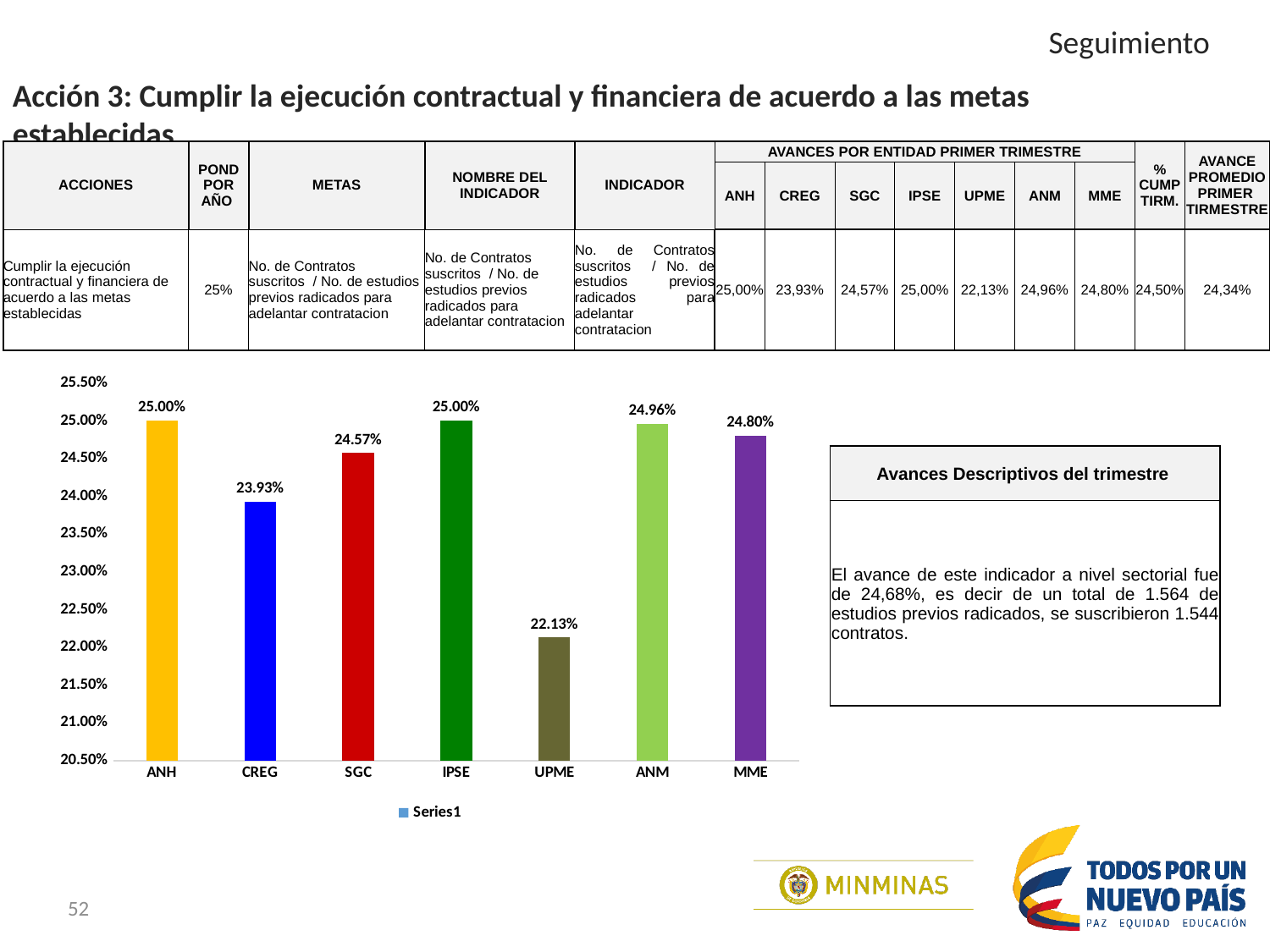
Which is larger, the value for SGC or the value for CREG? SGC What is the value for UPME? 22.13% Which category has the lowest value? UPME What is the value for CREG? 23.93% What is the value for ANM? 24.96% What is the value for ANH? 25.00% What kind of chart is shown on the slide? bar chart Is the value for UPME greater or less than 23.00%? less How many series does the legend list? 1 What is the difference between the values for ANH and CREG? 1.07% How many categories are shown on the x axis? 7 What is the difference between the values for SGC and UPME? 2.44%